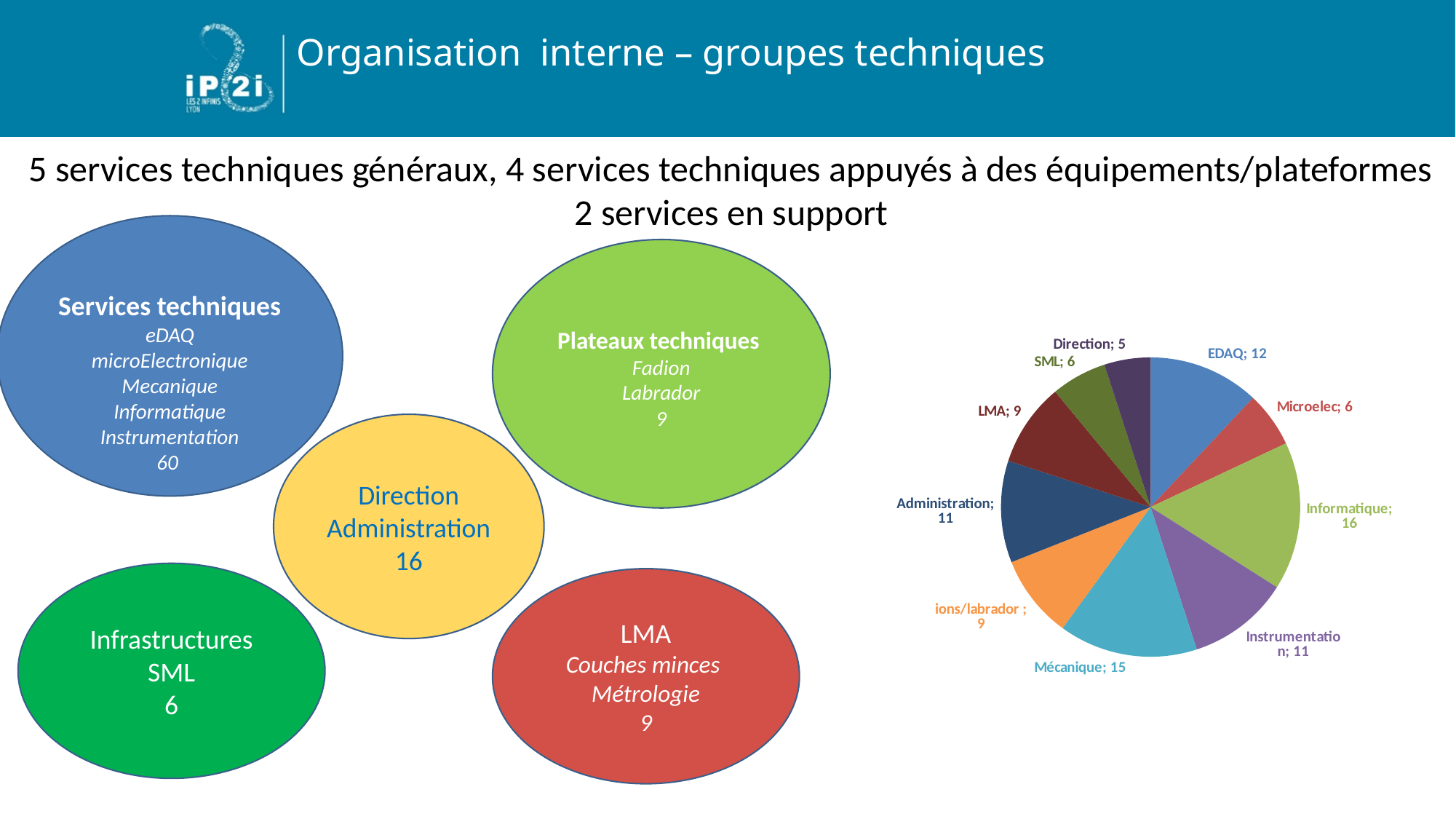
Which slice of the pie chart has the smallest value? Direction In the pie chart, what is the value for Informatique? 16 In the pie chart, what is the value for Mécanique? 15 In the pie chart, what is the value for Direction? 5 What kind of chart is shown on the right side of the slide? pie chart In the pie chart, what share of the total does Informatique represent? 16% In the pie chart, what is the value for EDAQ? 12 In the pie chart, what is the difference between the values for Informatique and Microelec? 10 In the pie chart, what is the difference between the values for EDAQ and LMA? 3 In the pie chart, which is larger: the value for Mécanique or the value for Administration? Mécanique Which slice of the pie chart has the largest value? Informatique How many slices does the pie chart have? 10